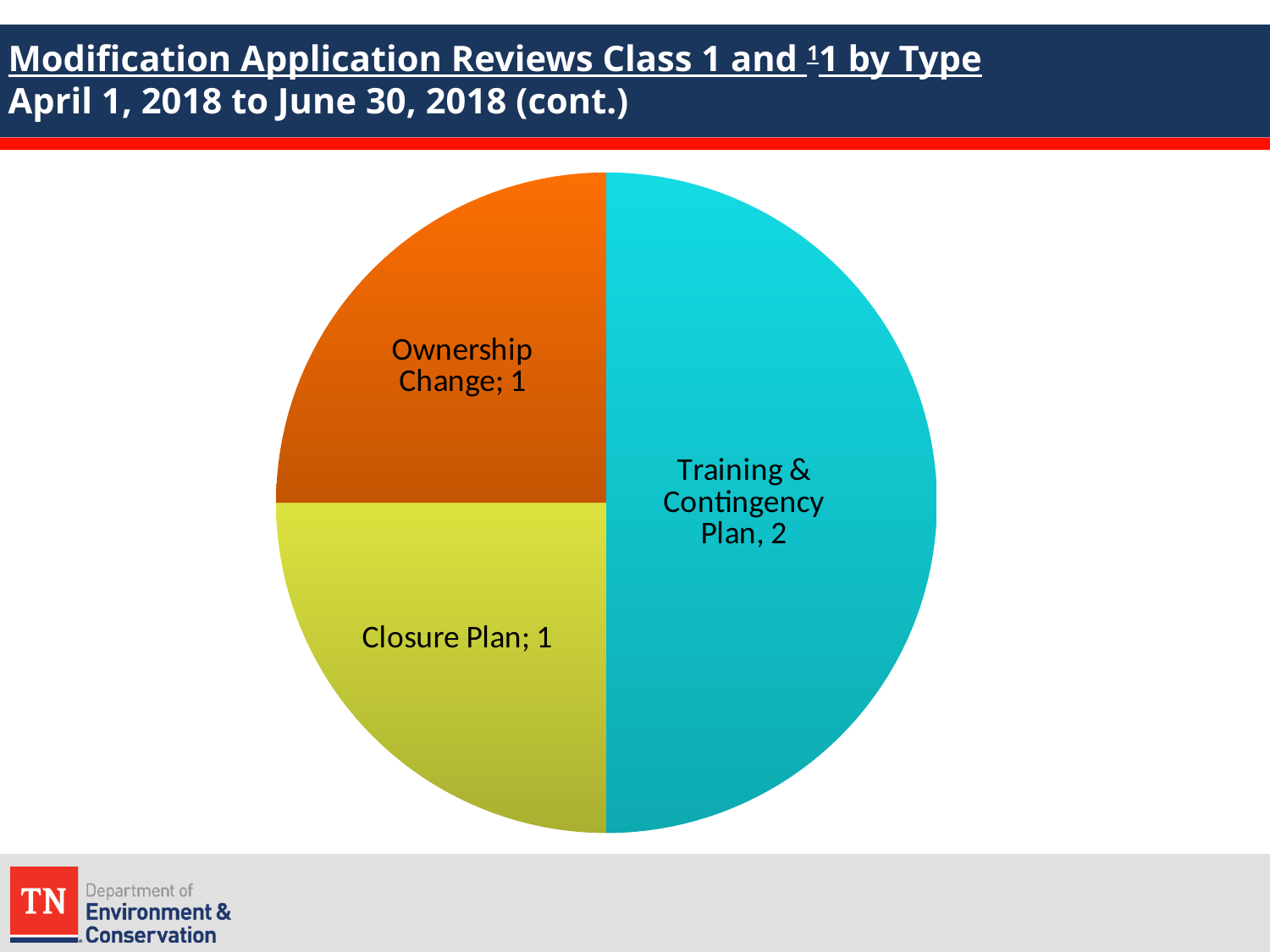
What share of the pie does Closure Plan represent? 25% What is the total of all slices in the pie chart? 4 Which is larger, the value for Training & Contingency Plan or the value for Ownership Change? Training & Contingency Plan What colour is the Training & Contingency Plan slice? teal/cyan What is the value for Training & Contingency Plan? 2 What share of the pie does Training & Contingency Plan represent? 50% What is the value for Ownership Change? 1 Which category has the largest slice? Training & Contingency Plan How many slices does the pie chart have? 3 What is the value for Closure Plan? 1 What is the difference between the values for Training & Contingency Plan and Closure Plan? 1 What kind of chart is shown on the slide? pie chart